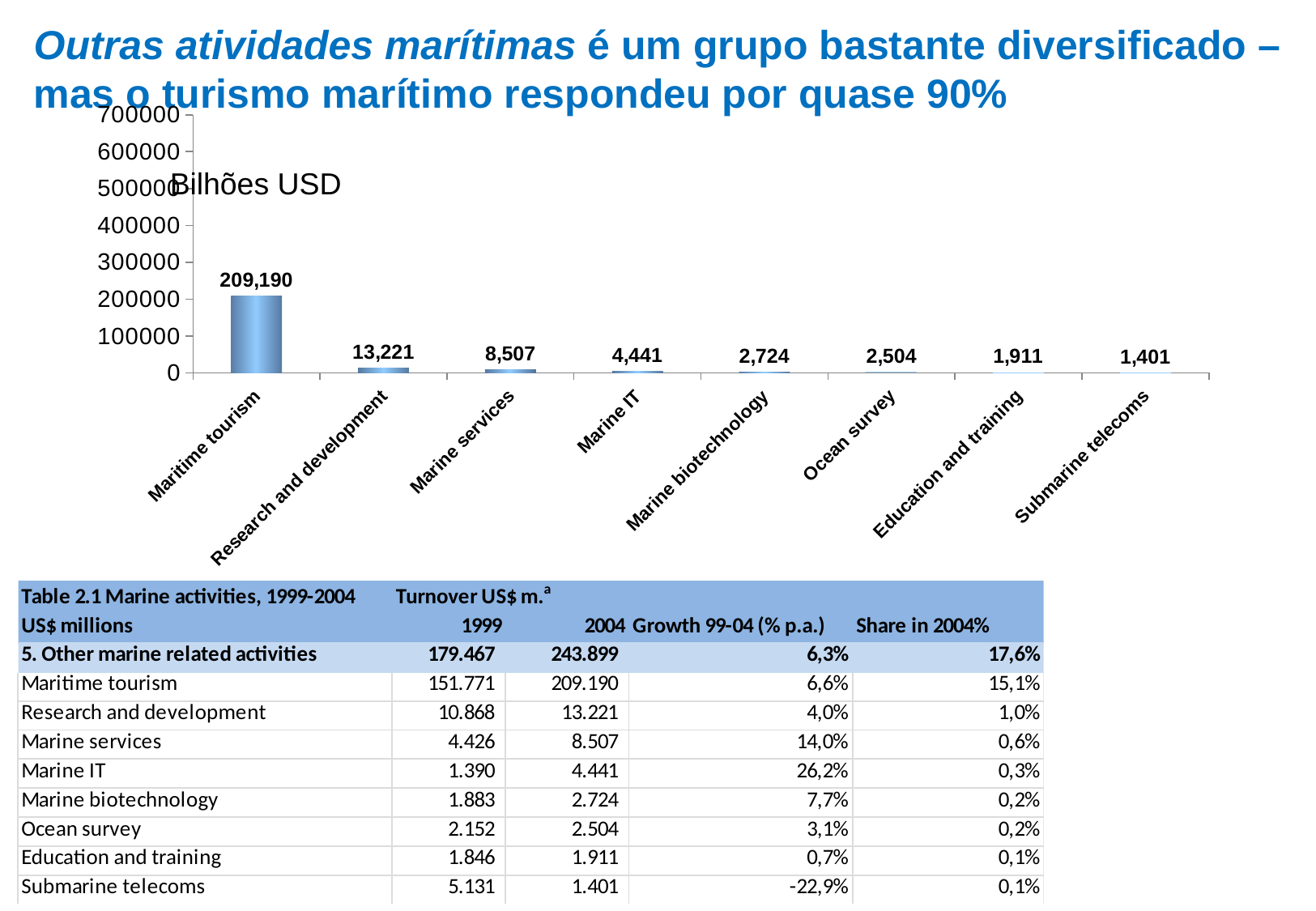
What is the value for Maritime tourism in the bar chart? 209,190 Is the value for Maritime tourism greater or less than 200000? greater Which category has the highest value in the bar chart? Maritime tourism What is the value for Submarine telecoms in the bar chart? 1,401 What is the difference between the values for Education and training and Submarine telecoms? 510 What is the difference between the values for Maritime tourism and Research and development? 195,969 Do the values rise or fall from left to right across the categories in the bar chart? fall What is the value for Research and development in the bar chart? 13,221 What is the value for Marine biotechnology in the bar chart? 2,724 How many categories are shown in the bar chart? 8 Which category has the lowest value in the bar chart? Submarine telecoms Which is larger, the value for Marine services or the value for Marine IT? Marine services